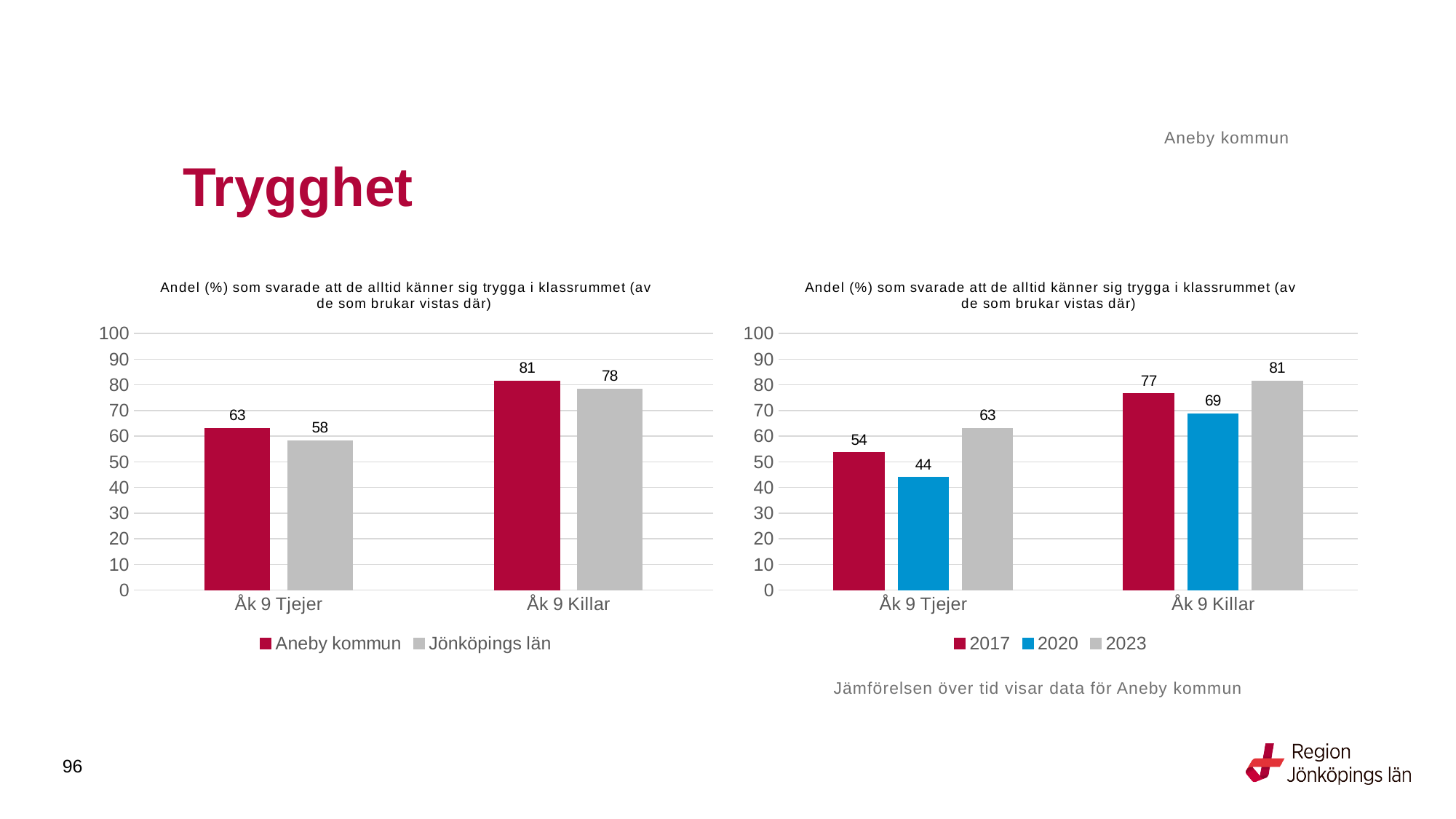
In the left chart, what is the value for Jönköpings län for Åk 9 Killar? 78 In the right chart, what is the difference between the 2023 and 2017 values for Åk 9 Tjejer? 9 What kind of chart is the right chart? Bar chart In the right chart, how many series does the legend list? 3 In the left chart, what is the difference between Aneby kommun and Jönköpings län for Åk 9 Tjejer? 5 In the left chart, what is the value for Aneby kommun for Åk 9 Tjejer? 63 In the left chart, how many series does the legend list? 2 In the right chart, what is the value for 2020 for Åk 9 Tjejer? 44 In the right chart, which year has the lowest value for Åk 9 Tjejer? 2020 In the right chart, what is the value for 2023 for Åk 9 Killar? 81 In the right chart, which category has the highest value for 2017? Åk 9 Killar In the left chart, which is larger for Åk 9 Killar: Aneby kommun or Jönköpings län? Aneby kommun